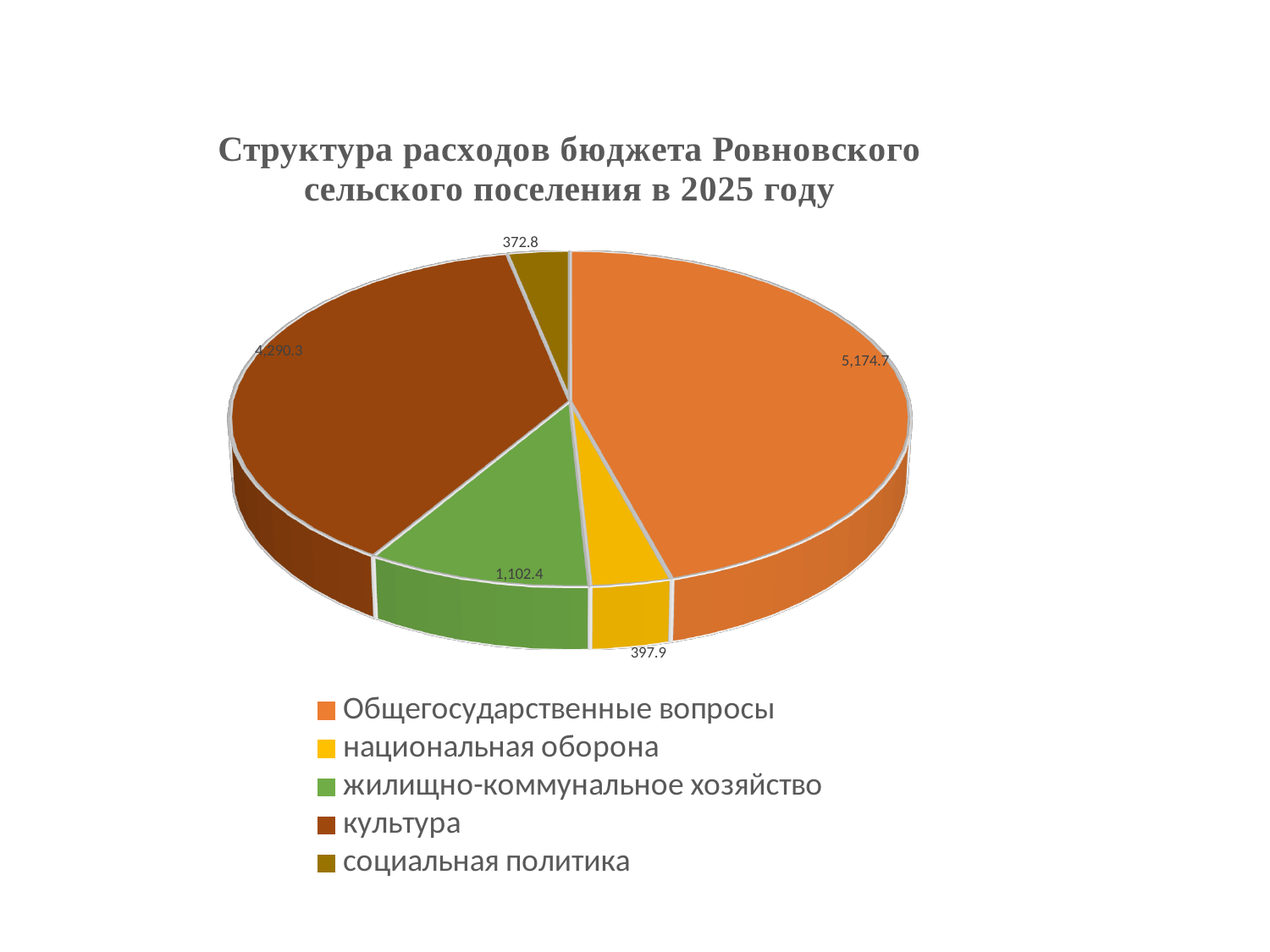
Which is larger, национальная оборона or социальная политика? национальная оборона What is the value for Общегосударственные вопросы? 5,174.7 Which category has the smallest slice? социальная политика What is the value for национальная оборона? 397.9 What is the value for культура? 4,290.3 What is the value for жилищно-коммунальное хозяйство? 1,102.4 What is the value for социальная политика? 372.8 What type of chart is shown on the slide? pie chart What is the difference between the values for Общегосударственные вопросы and культура? 884.4 What is the title of the chart? Структура расходов бюджета Ровновского сельского поселения в 2025 году Which category has the largest slice? Общегосударственные вопросы How many categories does the pie chart have? 5